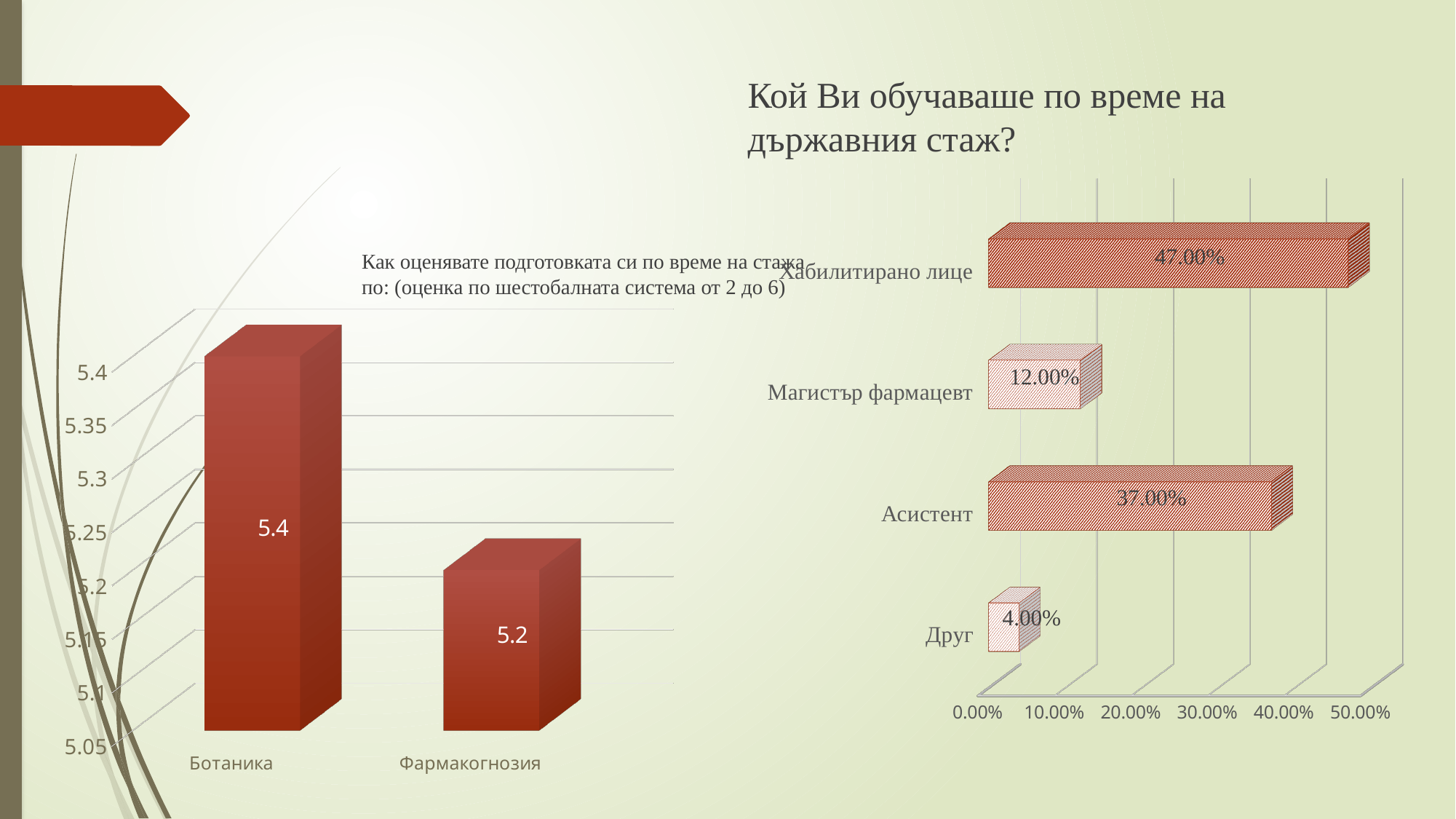
In the left chart (Как оценявате подготовката си по време на стажа), what is the difference between the values for Ботаника and Фармакогнозия? 0.2 In the right chart (Кой Ви обучаваше по време на държавния стаж?), which is larger: Асистент or Магистър фармацевт? Асистент In the right chart (Кой Ви обучаваше по време на държавния стаж?), which category has the lowest value? Друг In the right chart (Кой Ви обучаваше по време на държавния стаж?), what is the value for Магистър фармацевт? 12.00% In the right chart (Кой Ви обучаваше по време на държавния стаж?), what is the value for Хабилитирано лице? 47.00% In the right chart (Кой Ви обучаваше по време на държавния стаж?), what is the difference between Хабилитирано лице and Асистент? 10.00% What kind of chart is the right chart (Кой Ви обучаваше по време на държавния стаж?)? Bar chart In the left chart (Как оценявате подготовката си по време на стажа), how many categories are shown? 2 In the left chart (Как оценявате подготовката си по време на стажа), which category has the higher value? Ботаника In the left chart (Как оценявате подготовката си по време на стажа), what is the value for Фармакогнозия? 5.2 In the right chart (Кой Ви обучаваше по време на държавния стаж?), what is the value for Асистент? 37.00% In the left chart (Как оценявате подготовката си по време на стажа), what is the value for Ботаника? 5.4